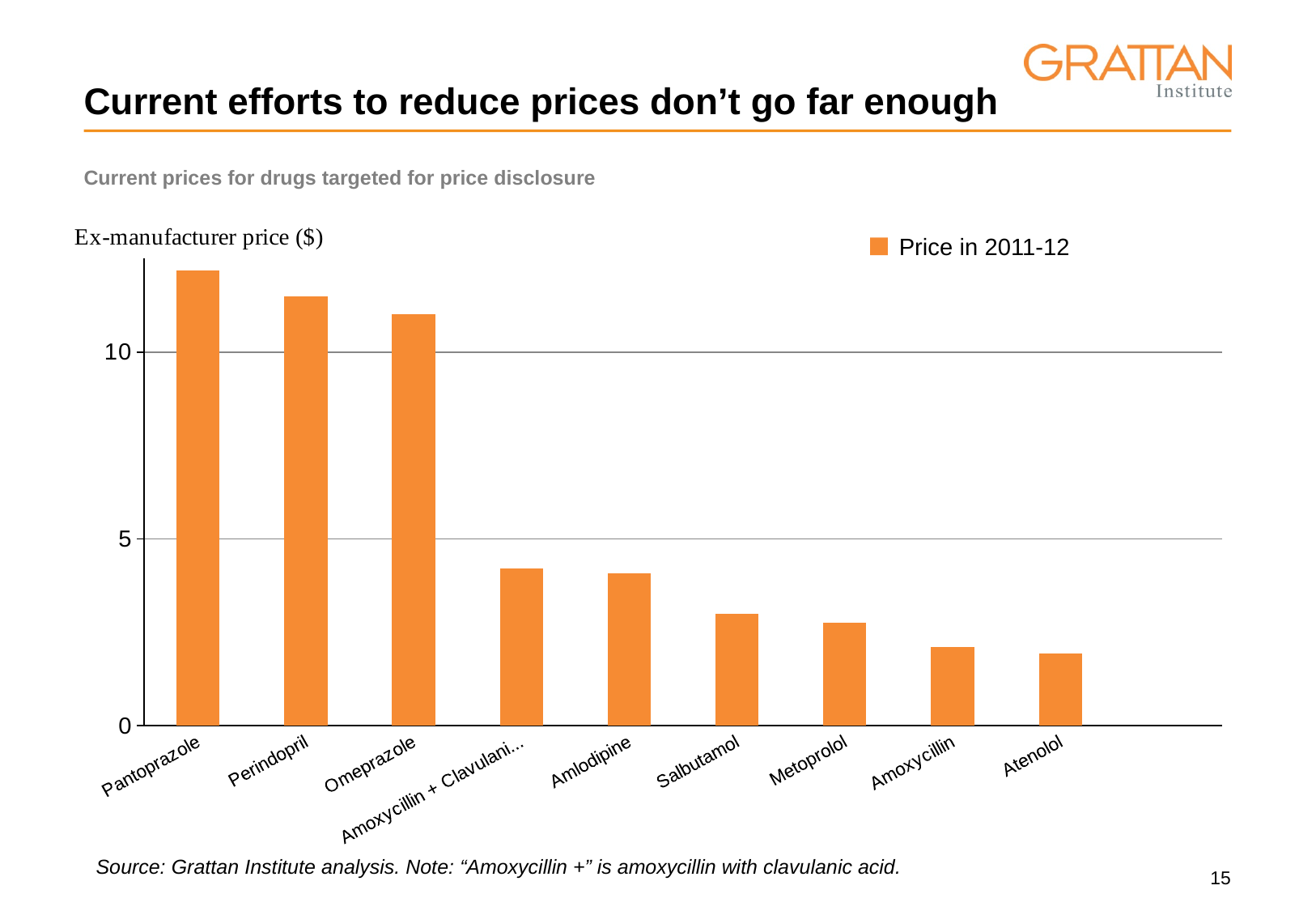
What kind of chart is shown on the slide? bar chart Do the bar values rise or fall moving from left to right along the x axis? fall Which has a higher ex-manufacturer price, Perindopril or Salbutamol? Perindopril Is the value for Omeprazole greater or less than 10? greater How many drugs are shown on the x axis of the chart? 9 Is the value for Pantoprazole greater or less than 10? greater What is the label on the vertical axis of the chart? Ex-manufacturer price ($) Is the value for Atenolol greater or less than 5? less Which drug has the highest ex-manufacturer price? Pantoprazole How many series does the chart's legend list? 1 What is the name of the series shown in the legend? Price in 2011-12